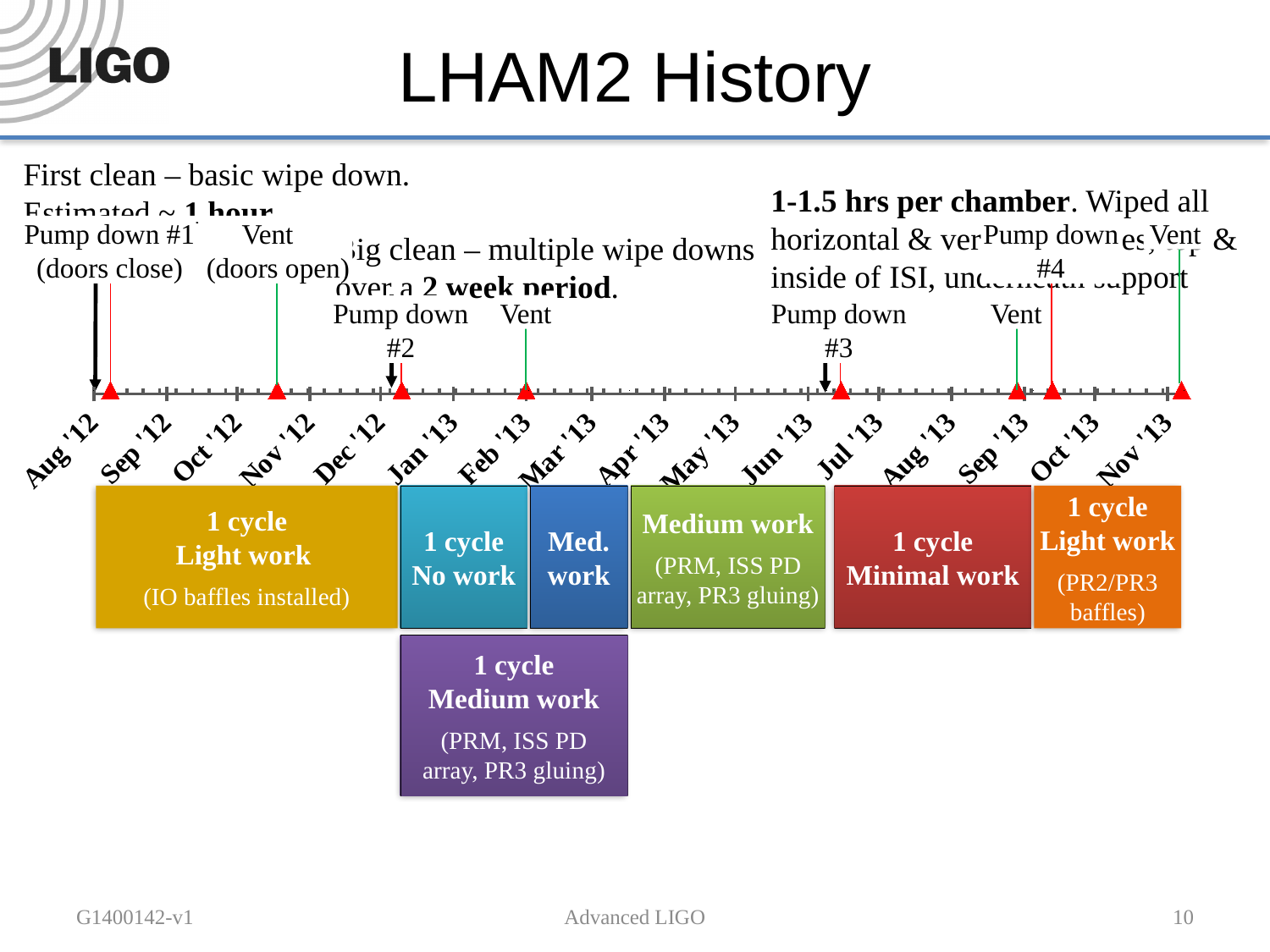
What kind of chart is shown on the slide? Timeline What work is listed in the purple block below the main row of blocks? 1 cycle Medium work (PRM, ISS PD array, PR3 gluing) Which pump down number is marked near Jul '13 on the timeline? #3 How many pump downs are labelled on the timeline? 4 How many month labels are shown along the timeline axis? 16 What work is listed in the red block spanning Jul '13 to Sep '13? 1 cycle Minimal work What is the last month label on the timeline axis? Nov '13 What is the first month label on the timeline axis? Aug '12 What work is listed in the orange block at the end of the timeline (Oct '13 to Nov '13)? 1 cycle Light work (PR2/PR3 baffles) How many red triangle markers are placed on the timeline axis? 8 What is the title of the slide containing the timeline? LHAM2 History What work is listed in the yellow block at the start of the timeline (Sep '12 to Jan '13)? 1 cycle Light work (IO baffles installed)